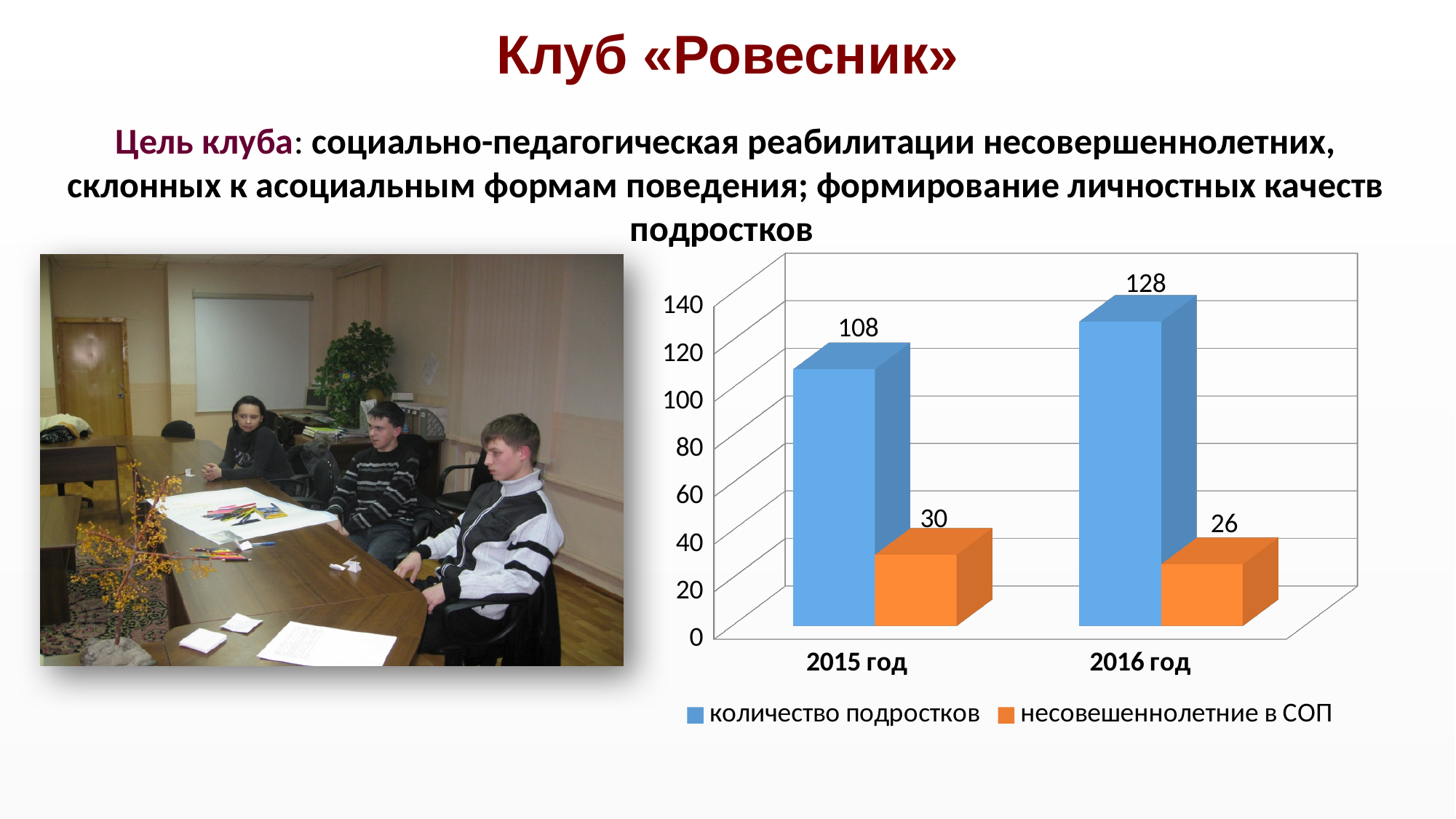
What is the difference between 'количество подростков' in 2016 год and 2015 год? 20 What kind of chart is shown on the slide? bar chart In which year is 'количество подростков' highest? 2016 год Which is larger: 'несовешеннолетние в СОП' in 2015 год or in 2016 год? 2015 год How many categories are shown on the x axis? 2 What is the value for 'количество подростков' in 2016 год? 128 What is the value for 'несовешеннолетние в СОП' in 2015 год? 30 Does 'несовешеннолетние в СОП' rise or fall from 2015 год to 2016 год? fall What is the value for 'несовешеннолетние в СОП' in 2016 год? 26 In which year is 'несовешеннолетние в СОП' lowest? 2016 год What is the value for 'количество подростков' in 2015 год? 108 How many series does the legend list? 2